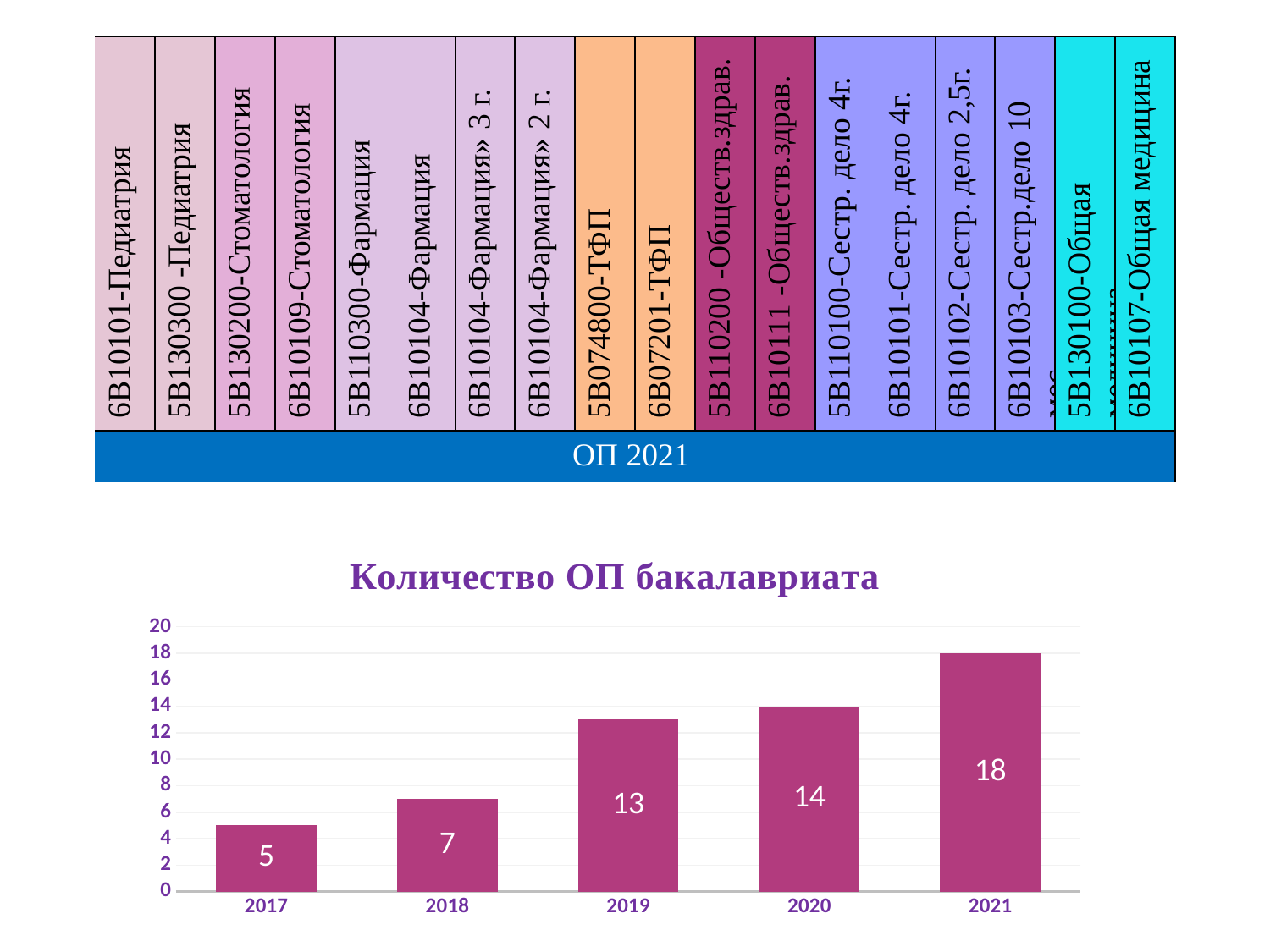
Do the values in the chart 'Количество ОП бакалавриата' rise or fall from 2017 to 2021? rise What is the value for 2019 in the chart 'Количество ОП бакалавриата'? 13 Which year has the lowest value in the chart 'Количество ОП бакалавриата'? 2017 What is the difference between the values for 2021 and 2020 in the chart 'Количество ОП бакалавриата'? 4 What kind of chart is 'Количество ОП бакалавриата'? bar chart Which is larger in the chart 'Количество ОП бакалавриата', the value for 2019 or the value for 2018? 2019 Which year has the highest value in the chart 'Количество ОП бакалавриата'? 2021 Is the value for 2020 in the chart 'Количество ОП бакалавриата' greater or less than 10? greater How many years are shown on the x axis of the chart 'Количество ОП бакалавриата'? 5 What is the value for 2017 in the chart 'Количество ОП бакалавриата'? 5 What is the difference between the values for 2018 and 2017 in the chart 'Количество ОП бакалавриата'? 2 What is the value for 2021 in the chart 'Количество ОП бакалавриата'? 18